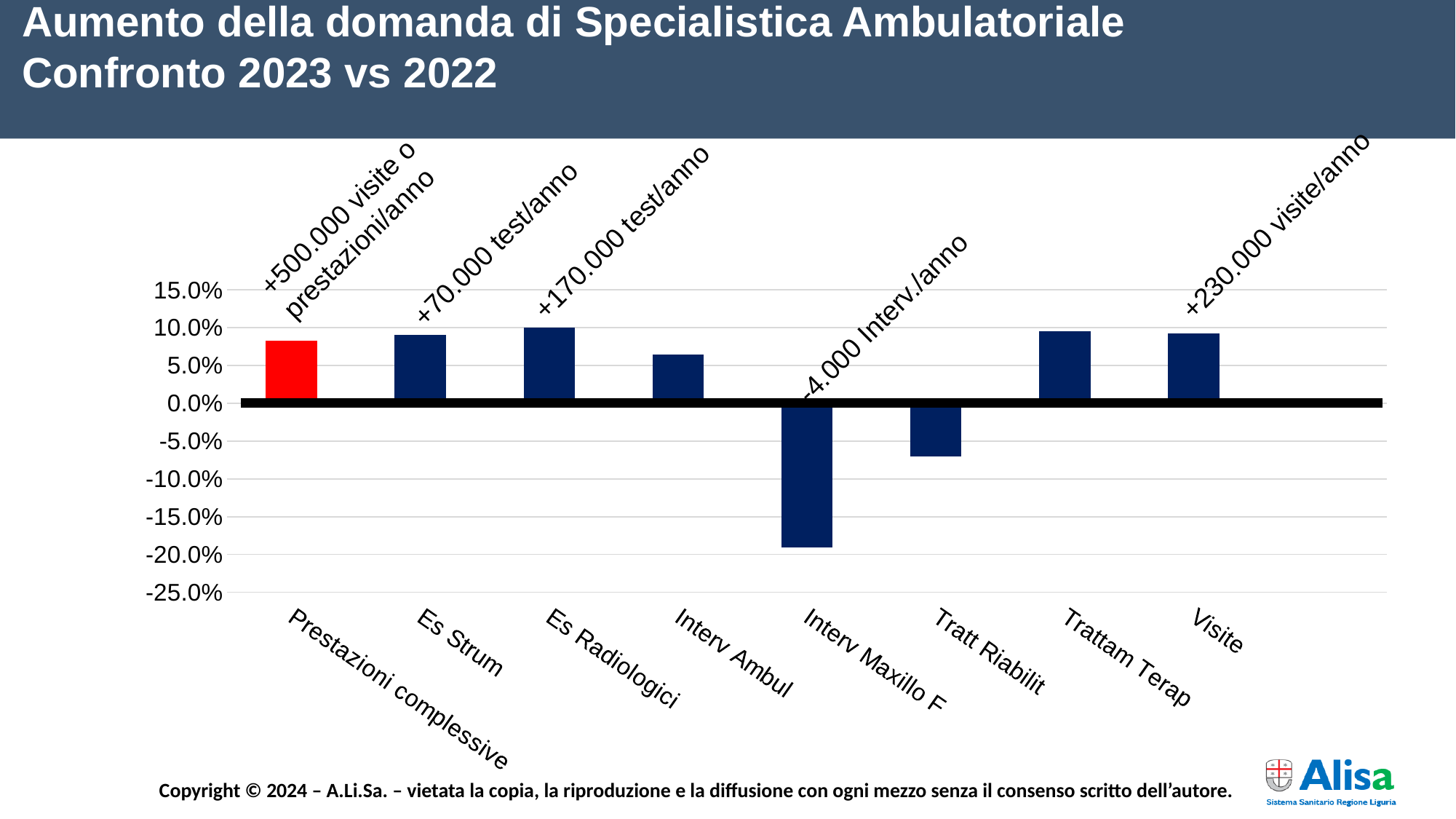
Is the value for Es Strum greater or less than 10.0%? less What annotation is written above the Visite bar? +230.000 visite/anno What colour is the bar for Prestazioni complessive? red How many categories are plotted on the x axis? 8 What kind of chart is shown on the slide? bar chart Is the value for Tratt Riabilit greater or less than -5.0%? less Is the value for Interv Ambul greater or less than 5.0%? greater Which is larger, the value for Tratt Riabilit or the value for Interv Maxillo F? Tratt Riabilit Which category has the lowest value? Interv Maxillo F Which is larger, the value for Es Strum or the value for Interv Ambul? Es Strum